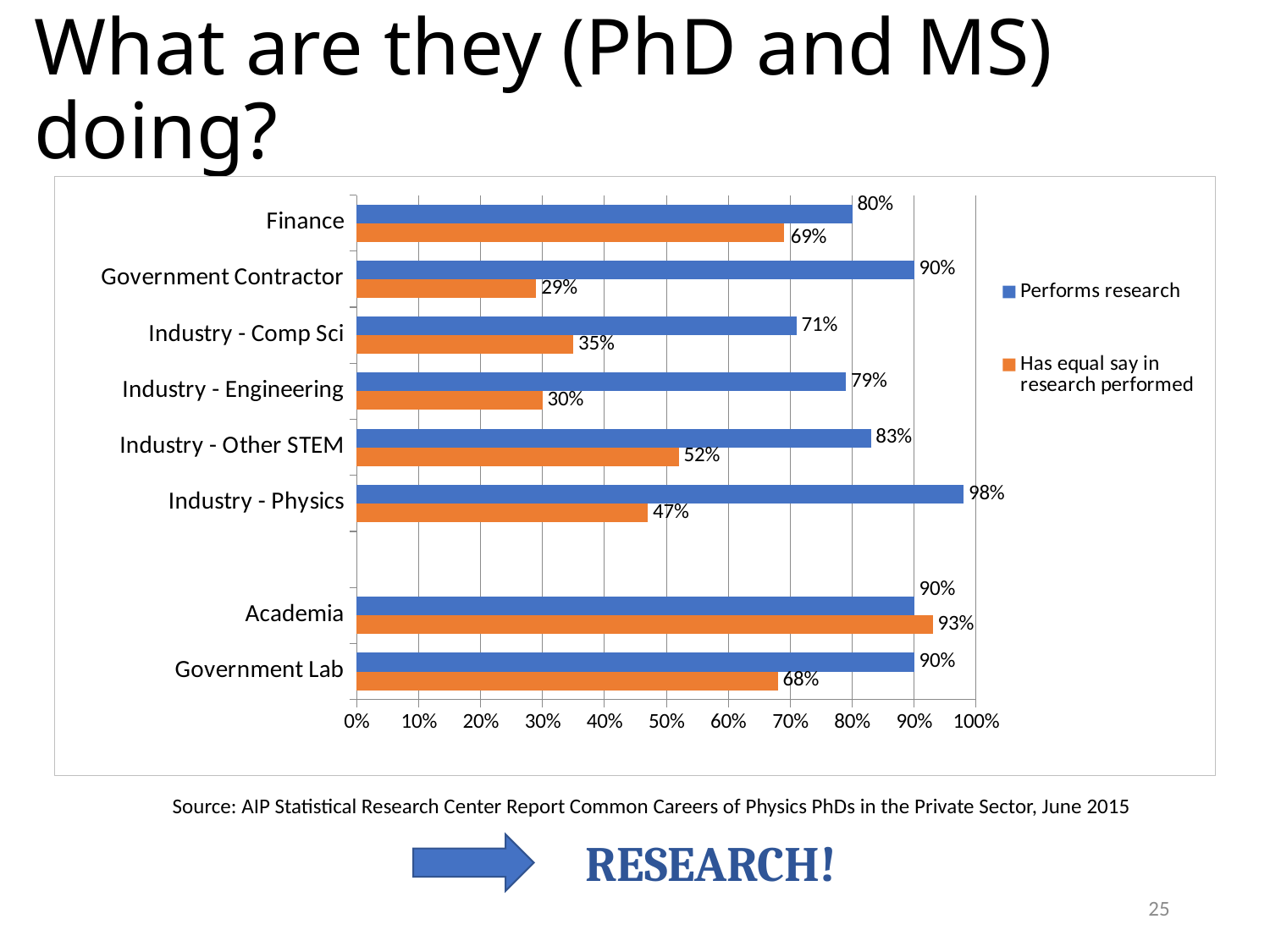
What is the 'Performs research' value for Academia? 90% Which category has the lowest 'Performs research' value? Industry - Comp Sci What is the 'Has equal say in research performed' value for Government Contractor? 29% How many labeled categories are shown on the chart? 8 Which category has the highest 'Has equal say in research performed' value? Academia What kind of chart is shown on the slide? Bar chart For Academia, which is larger: 'Performs research' or 'Has equal say in research performed'? Has equal say in research performed What is the difference between the 'Performs research' and 'Has equal say in research performed' values for Government Contractor? 61% How many series does the legend list? 2 Which category has the highest 'Performs research' value? Industry - Physics Which category has the lowest 'Has equal say in research performed' value? Government Contractor What percentage of Industry - Physics respondents perform research? 98%